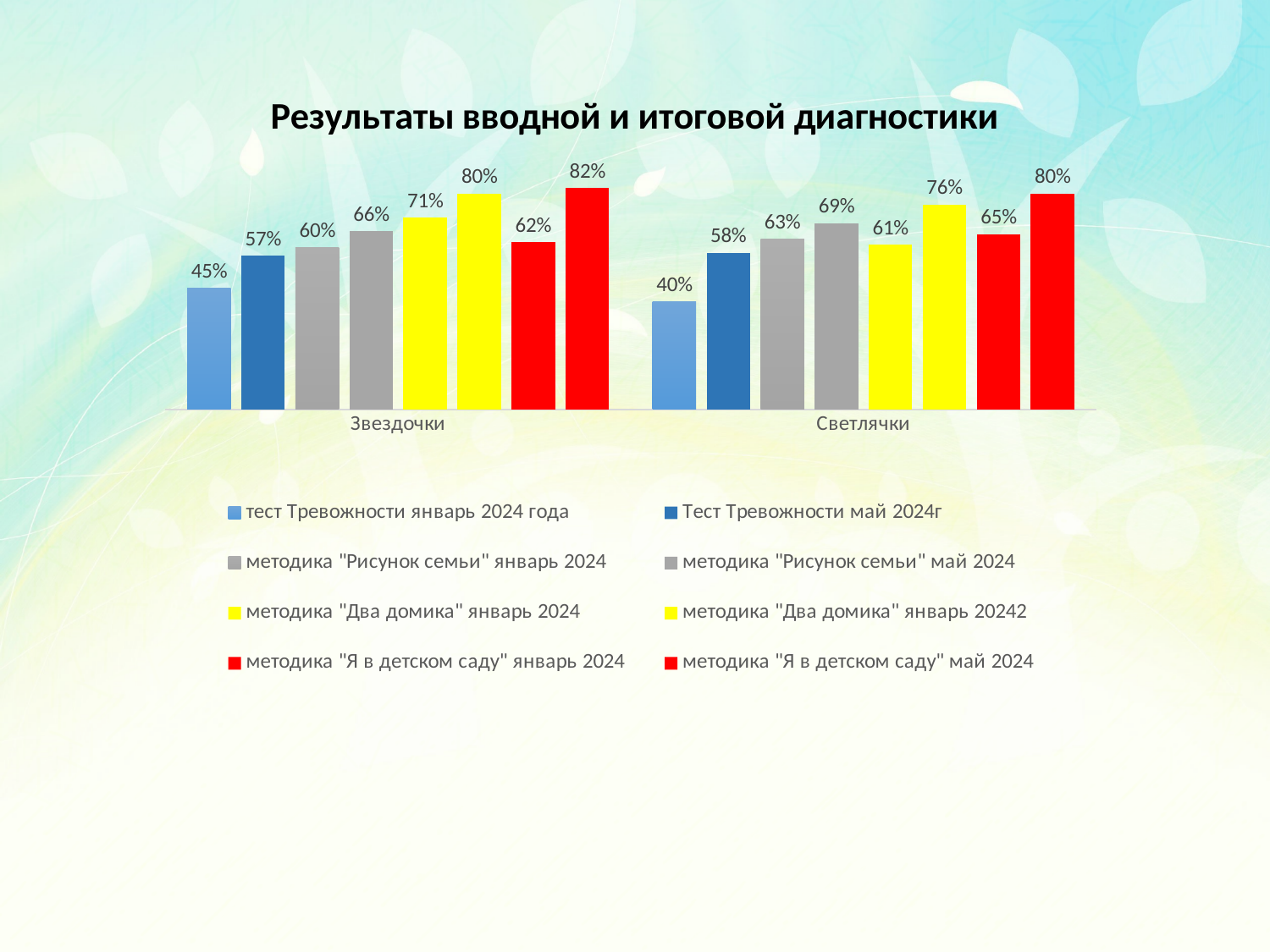
What is the difference between the highest value (82%) and the lowest value (45%) in the Звездочки group? 37 percentage points Which group has the larger value for "тест Тревожности январь 2024 года": Звездочки or Светлячки? Звездочки What colour are the bars for the "методика "Два домика"" series? yellow What type of chart is shown on the slide? bar chart What is the value of the last (rightmost) bar in the Светлячки group, "методика "Я в детском саду" май 2024"? 80% How many categories (groups) are shown on the x axis? 2 What is the value for "Тест Тревожности май 2024г" in the Светлячки group? 58% What is the title of the chart? Результаты вводной и итоговой диагностики How many series does the legend list? 8 What is the value for "тест Тревожности январь 2024 года" in the Звездочки group? 45% What is the lowest value shown in the Светлячки group? 40% What is the highest value shown in the Звездочки group? 82%